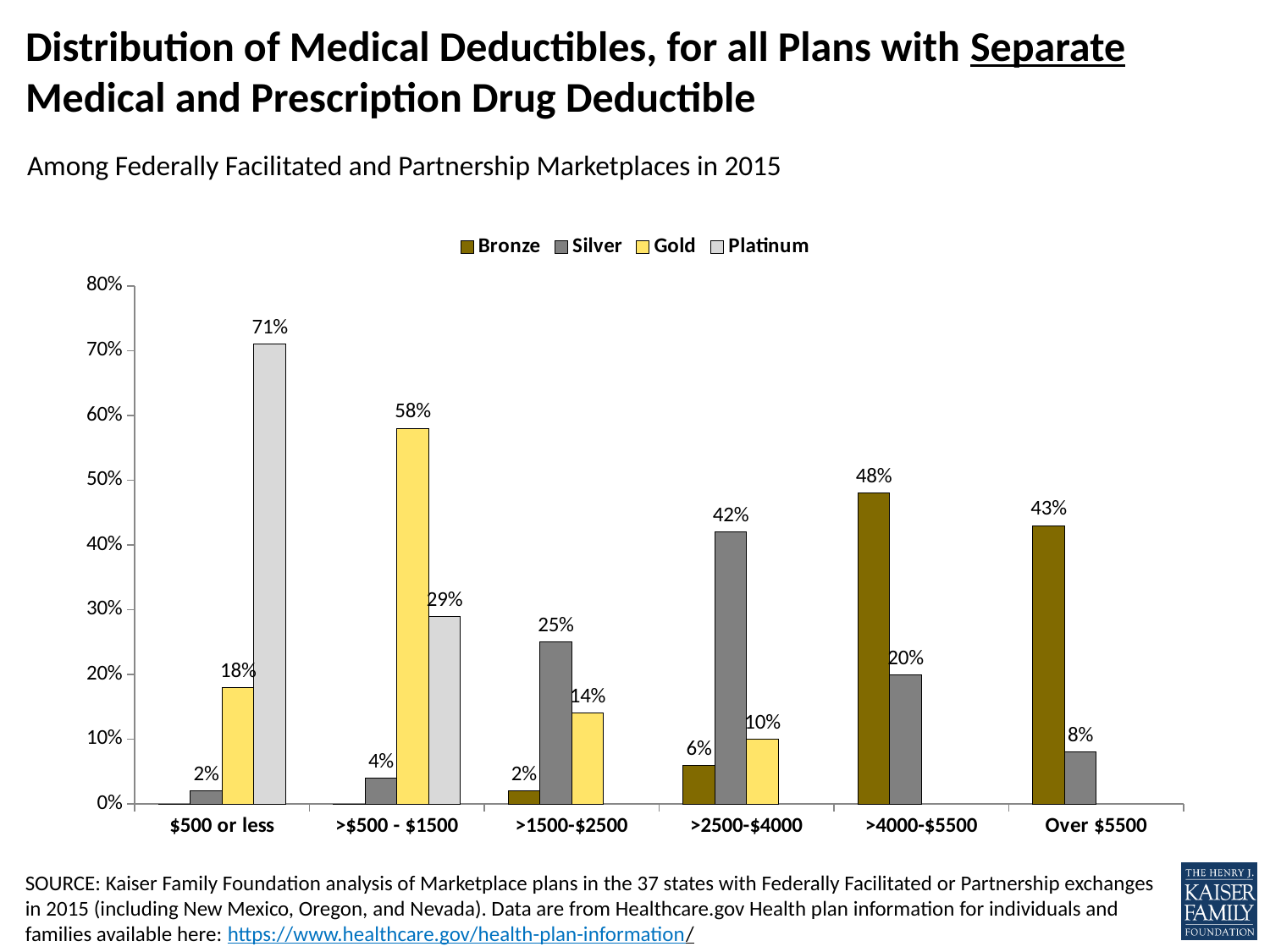
Which deductible category has the highest Bronze value? >4000-$5500 Which deductible category has the lowest Silver value? $500 or less What is the Gold value for the ">$500 - $1500" category? 58% What is the Platinum value for the "$500 or less" category? 71% What is the difference between the Platinum and Gold values in the "$500 or less" category? 53% What is the Bronze value for the ">4000-$5500" category? 48% What is the Silver value for the ">2500-$4000" category? 42% Which is larger in the ">1500-$2500" category, Silver or Gold? Silver What kind of chart is shown on the slide? Bar chart How many series does the legend list? 4 How many deductible categories are shown on the x axis? 6 Which series is shown in yellow in the legend? Gold